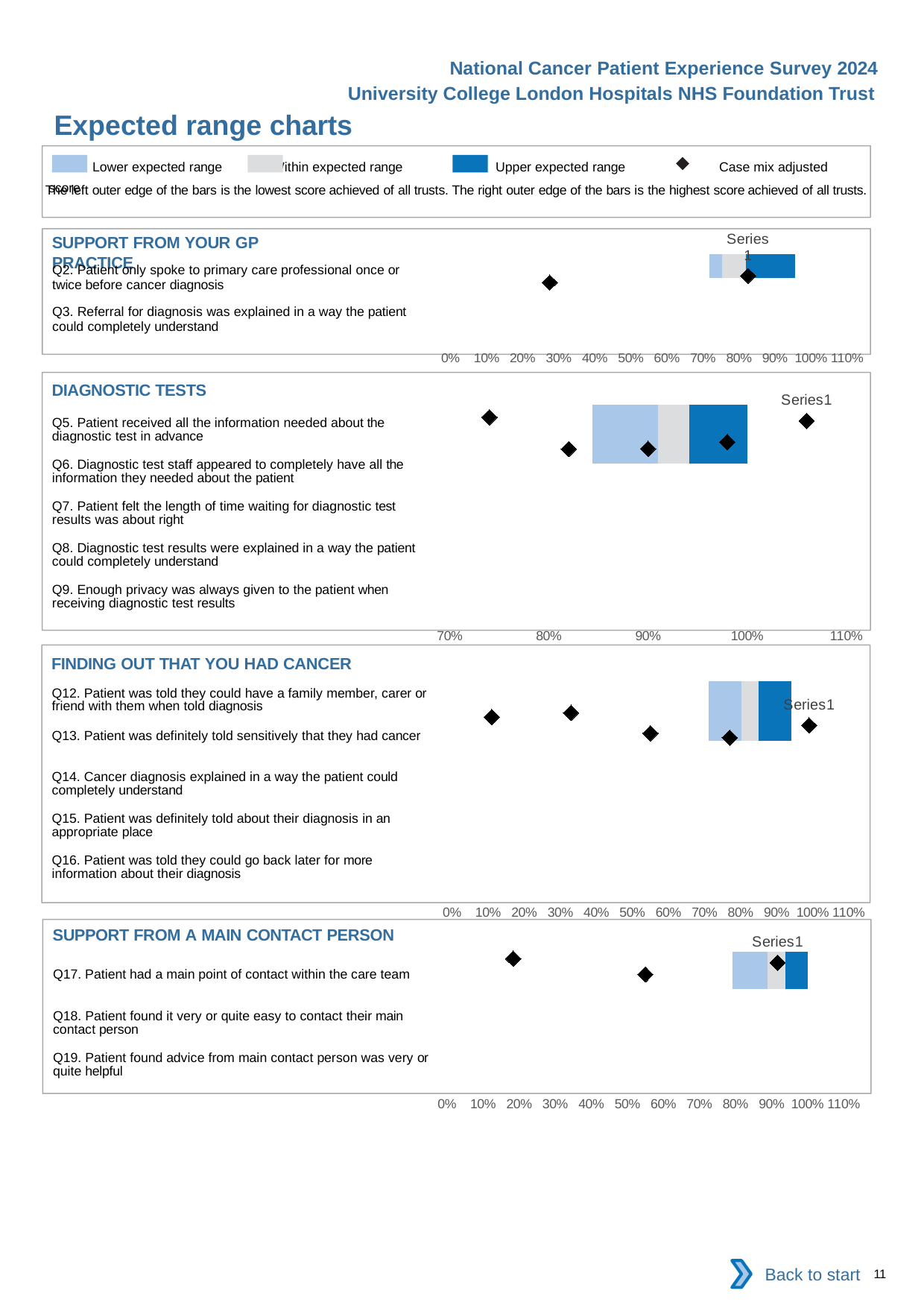
How many questions are listed in the 'DIAGNOSTIC TESTS' chart? 5 How many questions are listed in the 'SUPPORT FROM A MAIN CONTACT PERSON' chart? 3 How many entries does the legend at the top of the slide list? 4 How many questions are listed in the 'FINDING OUT THAT YOU HAD CANCER' chart? 5 What is the lowest axis tick shown on the 'DIAGNOSTIC TESTS' chart? 70% What kind of chart is used in the 'DIAGNOSTIC TESTS' section? bar chart What is the highest axis tick shown on the 'SUPPORT FROM A MAIN CONTACT PERSON' chart? 110% What does the diamond marker represent according to the legend? Case mix adjusted score